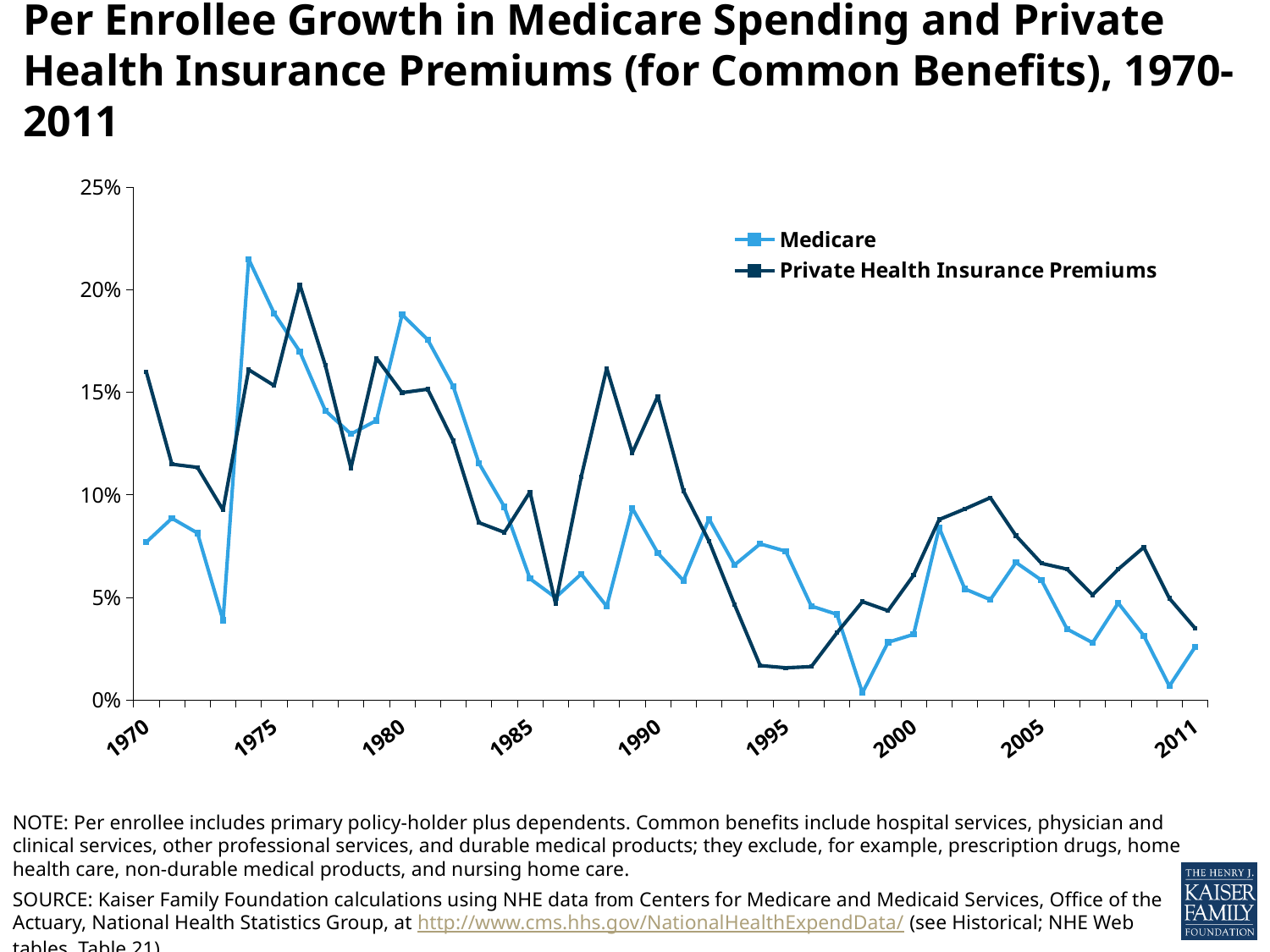
In which year does the Medicare line reach its highest value? 1974 In which year does the Private Health Insurance Premiums line reach its highest value? 1976 Which colour is used for the Medicare line? Light blue In 1970, which series has the higher value, Medicare or Private Health Insurance Premiums? Private Health Insurance Premiums In 1995, which series has the higher value, Medicare or Private Health Insurance Premiums? Medicare Is the Medicare value in 1974 greater or less than 20%? greater Which two series are plotted on the chart? Medicare and Private Health Insurance Premiums How many series does the legend list? 2 Overall, do the growth rates for both series rise or fall between 1970 and 2011? Fall What kind of chart is shown on the slide? Line chart Is the Private Health Insurance Premiums value in 1995 greater or less than 5%? less Is the Medicare value in 1970 greater or less than 10%? less